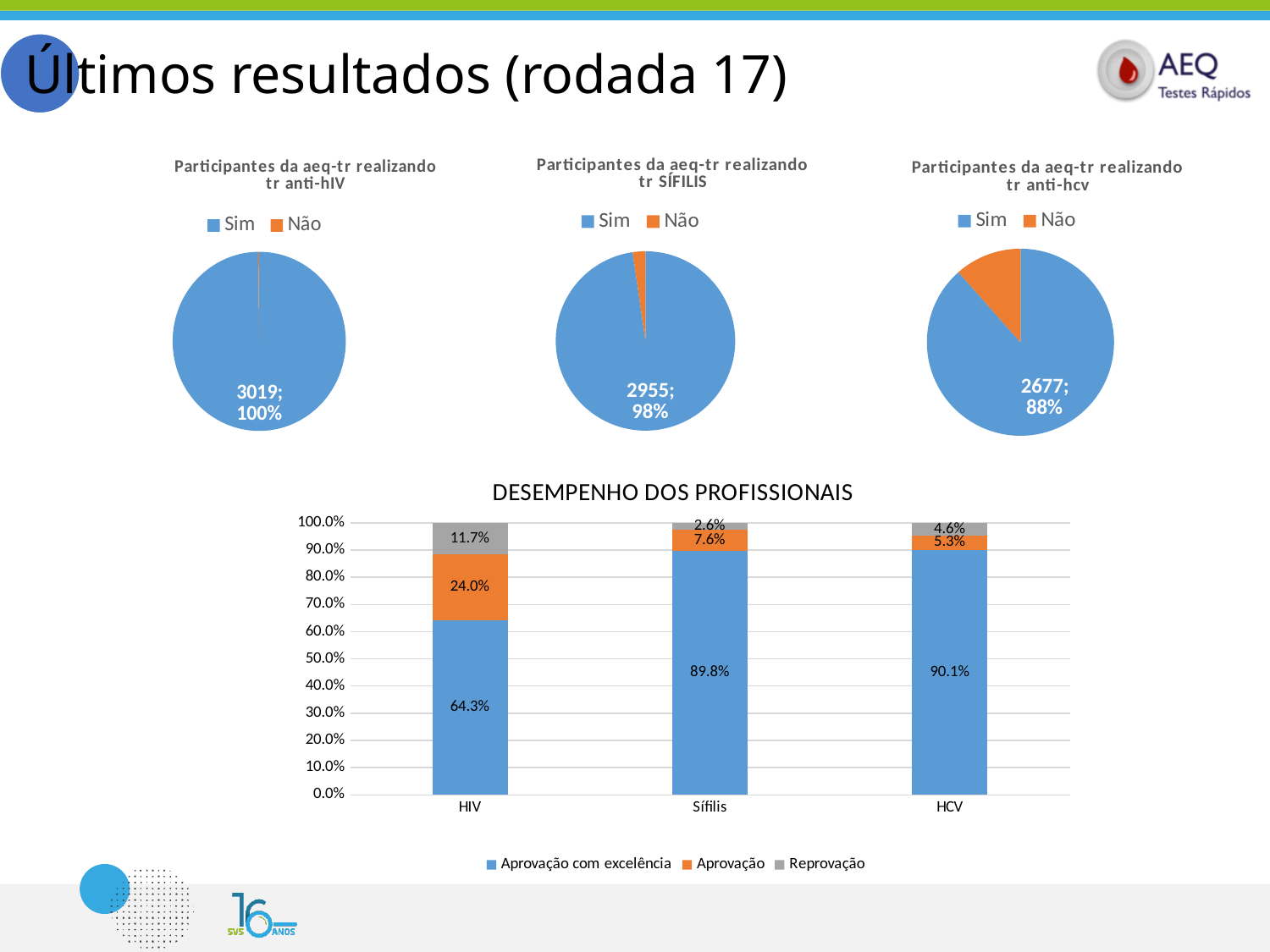
What kind of chart is 'DESEMPENHO DOS PROFISSIONAIS'? Stacked bar chart How many categories are shown on the x axis of the bar chart 'DESEMPENHO DOS PROFISSIONAIS'? 3 In the bar chart 'DESEMPENHO DOS PROFISSIONAIS', what is the difference between the 'Aprovação' values for HIV and HCV? 18.7 percentage points In the bar chart 'DESEMPENHO DOS PROFISSIONAIS', what is the 'Aprovação' value for Sífilis? 7.6% In the bar chart 'DESEMPENHO DOS PROFISSIONAIS', which category has the lowest 'Reprovação' value? Sífilis In the bar chart 'DESEMPENHO DOS PROFISSIONAIS', what is the 'Reprovação' value for HIV? 11.7% In the bar chart 'DESEMPENHO DOS PROFISSIONAIS', what is the value of 'Aprovação com excelência' for HIV? 64.3% In the pie chart 'Participantes da aeq-tr realizando tr anti-hcv', what is the value shown for the 'Sim' slice? 2677 In the bar chart 'DESEMPENHO DOS PROFISSIONAIS', which has the larger 'Reprovação' value, HIV or HCV? HIV In the bar chart 'DESEMPENHO DOS PROFISSIONAIS', which category has the highest 'Aprovação com excelência' value? HCV In the pie chart 'Participantes da aeq-tr realizando tr SÍFILIS', what share does the 'Sim' slice represent? 98% How many series does the legend of the bar chart 'DESEMPENHO DOS PROFISSIONAIS' list? 3